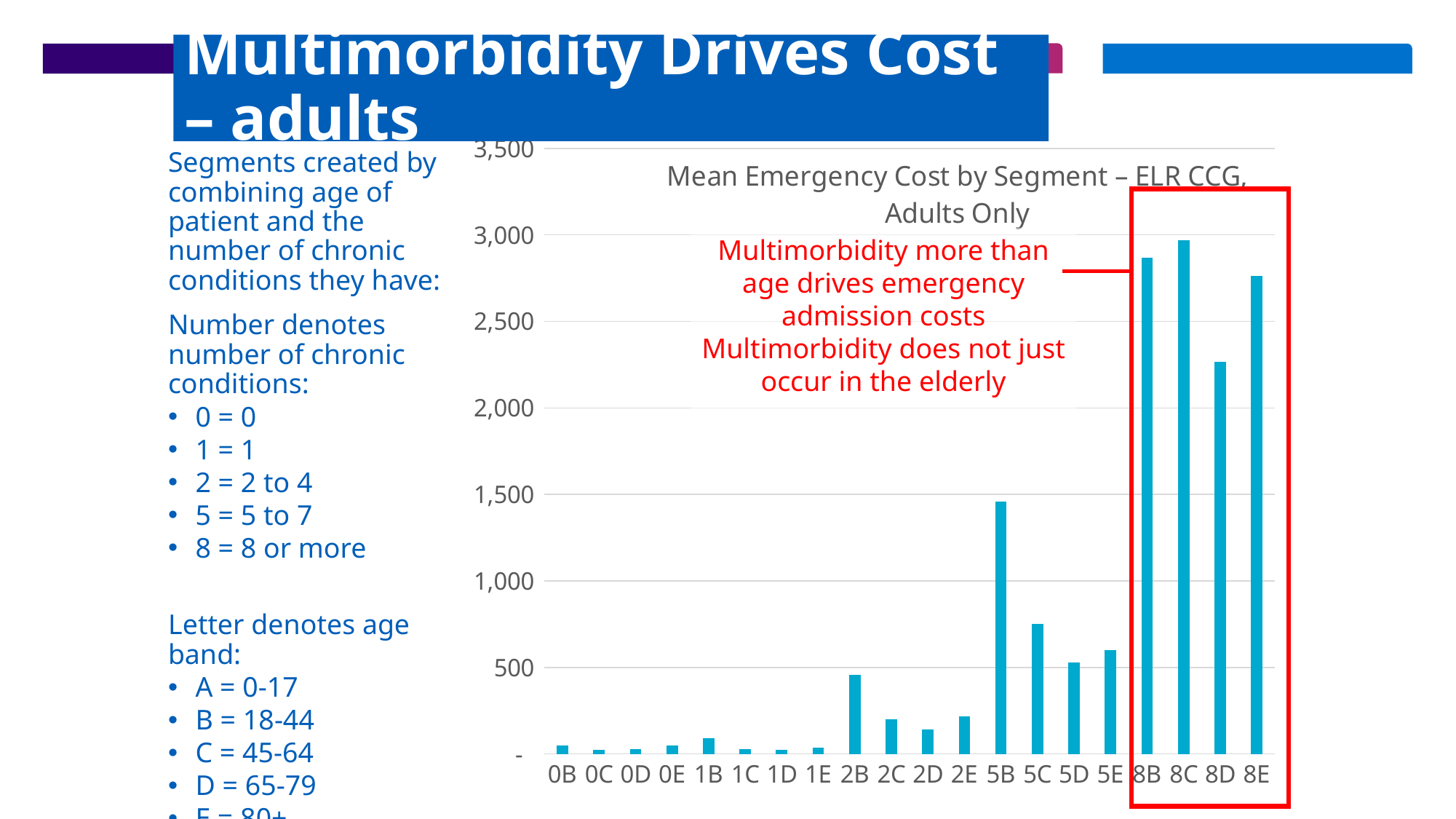
Is the value for segment 8C greater or less than 2,500? greater Which has the larger mean emergency cost, segment 8B or segment 8D? 8B Which segments are enclosed by the red box on the chart? 8B, 8C, 8D, 8E What is the title of the chart? Mean Emergency Cost by Segment – ELR CCG, Adults Only Which has the larger mean emergency cost, segment 5B or segment 5C? 5B Is the value for segment 8D greater or less than 2,000? greater Is the value for segment 5C greater or less than 500? greater What type of chart is shown on the slide? bar chart Which segment has the highest mean emergency cost? 8C How many segments (bars) are plotted on the x axis? 20